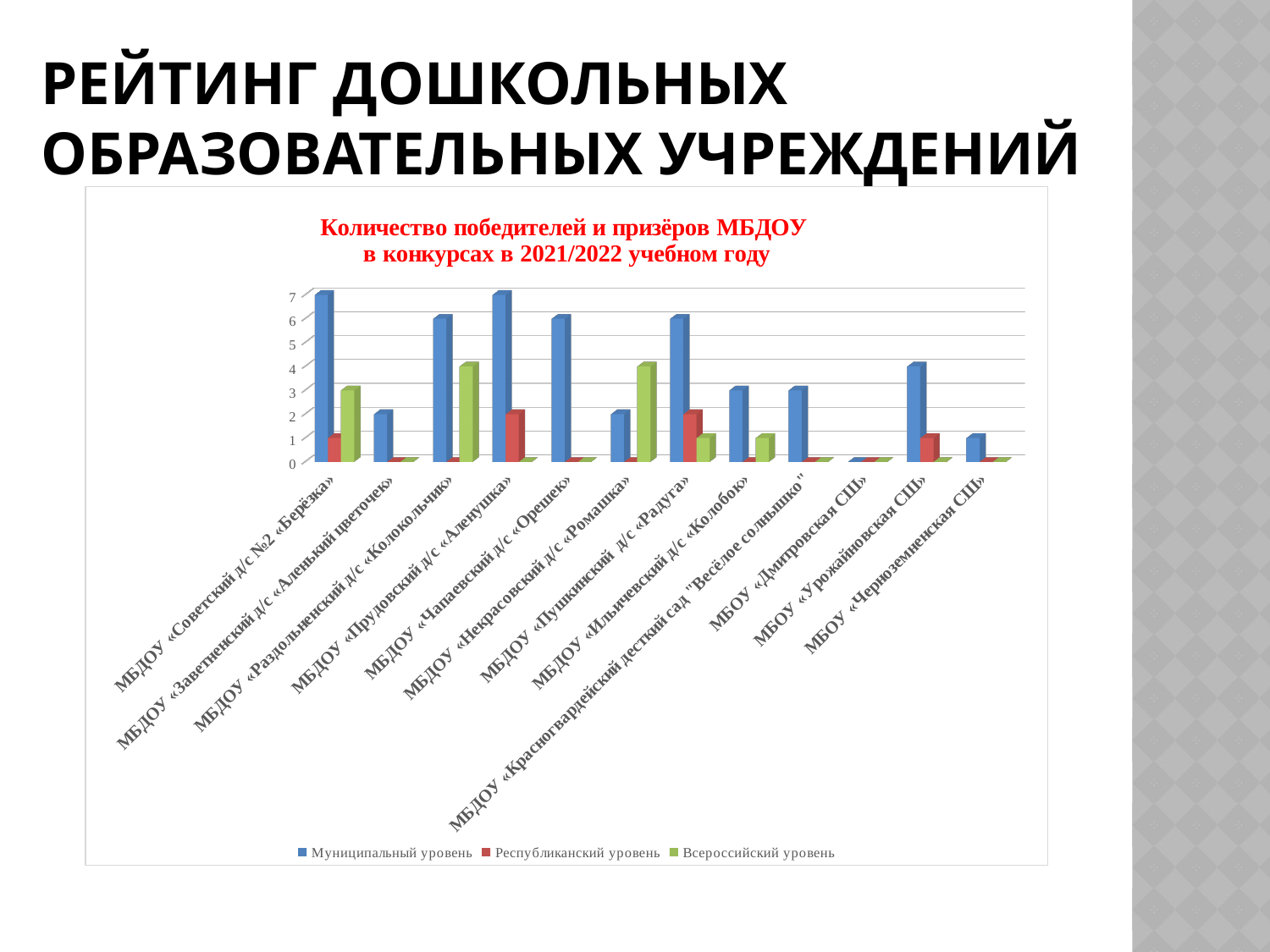
How many series does the legend list? 3 Which is larger: the Муниципальный уровень value for МБДОУ «Некрасовский д/с «Ромашка» or its Всероссийский уровень value? Всероссийский уровень Which series is shown in green in the legend? Всероссийский уровень What is the value of Всероссийский уровень for МБДОУ «Советский д/с №2 «Берёзка»? 3 What is the value of Муниципальный уровень for МБДОУ «Чапаевский д/с «Орешек»? 6 Is the Муниципальный уровень value for МБДОУ «Раздольненский д/с «Колокольчик» greater or less than 4? greater What is the value of Республиканский уровень for МБДОУ «Прудовский д/с «Аленушка»? 2 How many institutions (categories) are shown on the x axis? 12 Which institution has the lowest Муниципальный уровень value? МБОУ «Дмитровская СШ» What kind of chart is shown on the slide? bar chart Is the Муниципальный уровень value for МБОУ «Чернозёмненская СШ» greater or less than 3? less What is the title of the chart? Количество победителей и призёров МБДОУ в конкурсах в 2021/2022 учебном году